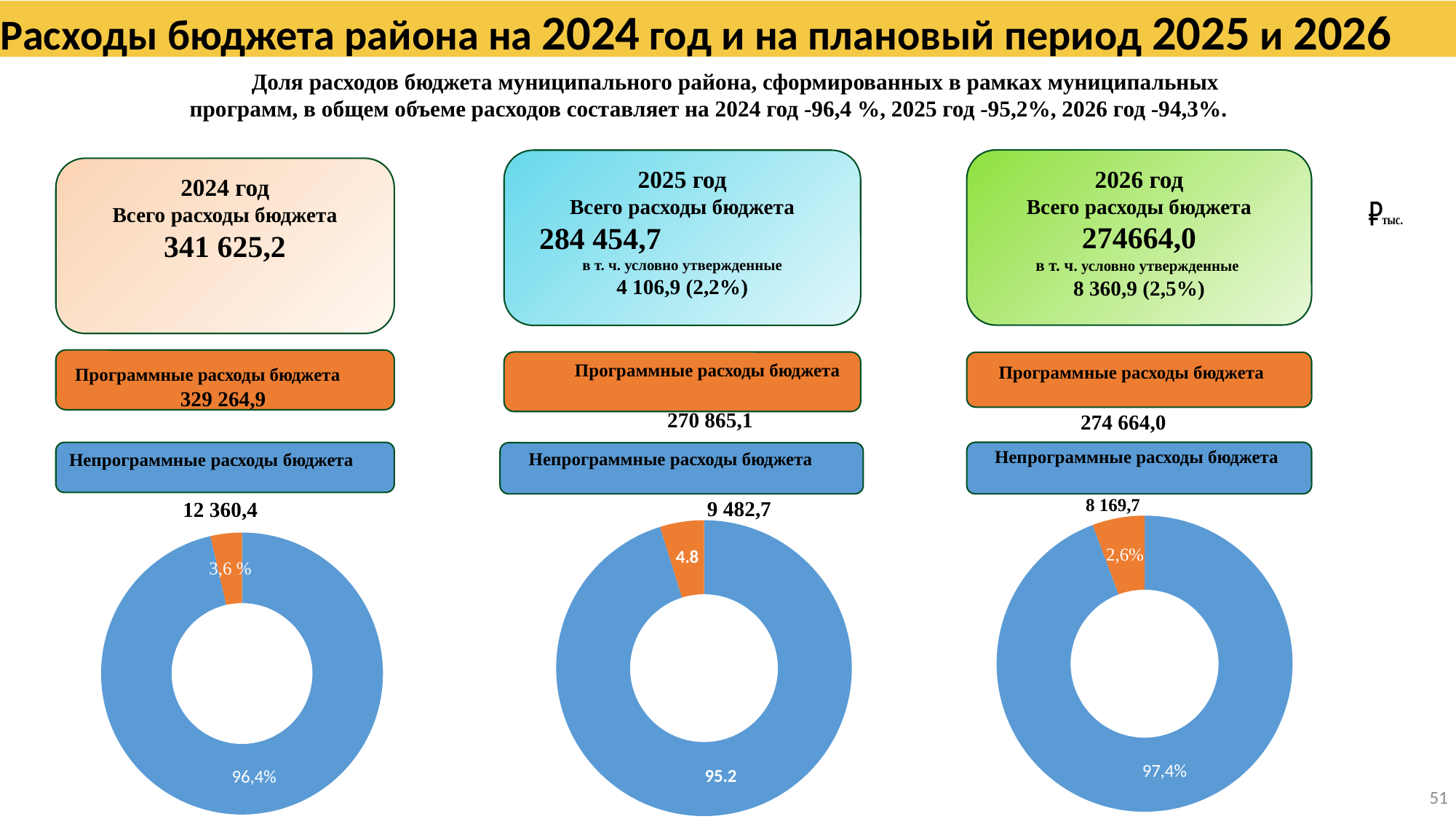
How many slices does each doughnut chart on the slide contain? 2 What kind of chart is used for the 2024 год chart at the bottom left of the slide? Doughnut (pie) chart In the 2024 год doughnut chart, which slice is larger, the blue one or the orange one? The blue one How many doughnut charts are shown on the slide? 3 In the 2024 год doughnut chart, what share is shown for the large blue slice? 96,4% In the 2024 год doughnut chart, what share is shown for the small orange slice? 3,6 % In the 2025 год doughnut chart, what value is printed on the blue slice? 95.2